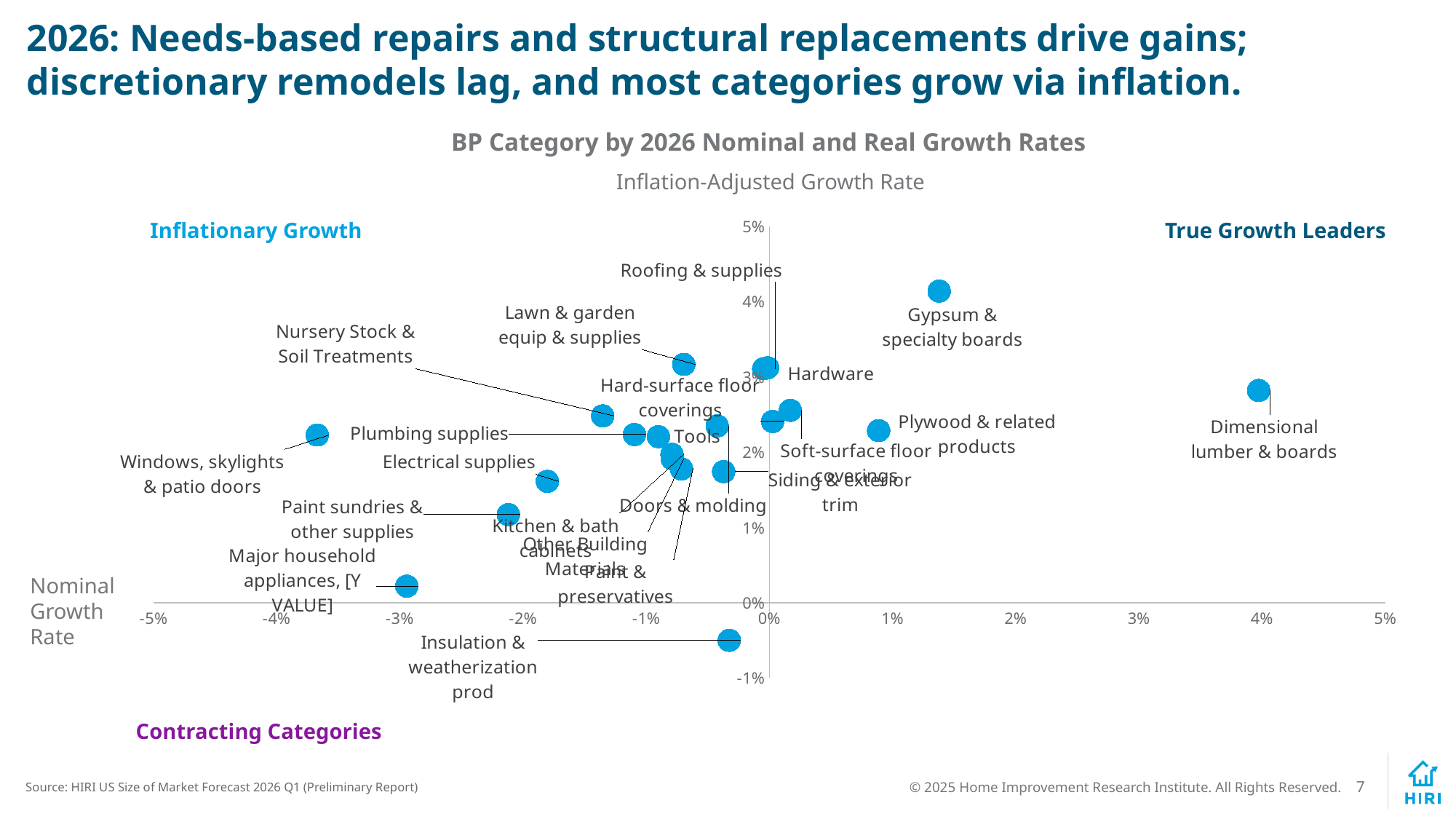
Which category has the highest nominal growth rate? Gypsum & specialty boards Which category has the highest inflation-adjusted growth rate? Dimensional lumber & boards Which has the higher nominal growth rate, Windows, skylights & patio doors or Major household appliances? Windows, skylights & patio doors Is the nominal growth rate for Insulation & weatherization prod greater or less than 0%? less Which category has the lowest inflation-adjusted growth rate? Windows, skylights & patio doors Which quadrant label appears in the top-right corner of the chart? True Growth Leaders Is the inflation-adjusted growth rate for Major household appliances greater or less than -2%? less What kind of chart is shown on the slide? Scatter chart What is the title of the chart? BP Category by 2026 Nominal and Real Growth Rates Is the inflation-adjusted growth rate for Dimensional lumber & boards greater or less than 3%? greater Which category has the lowest nominal growth rate? Insulation & weatherization prod